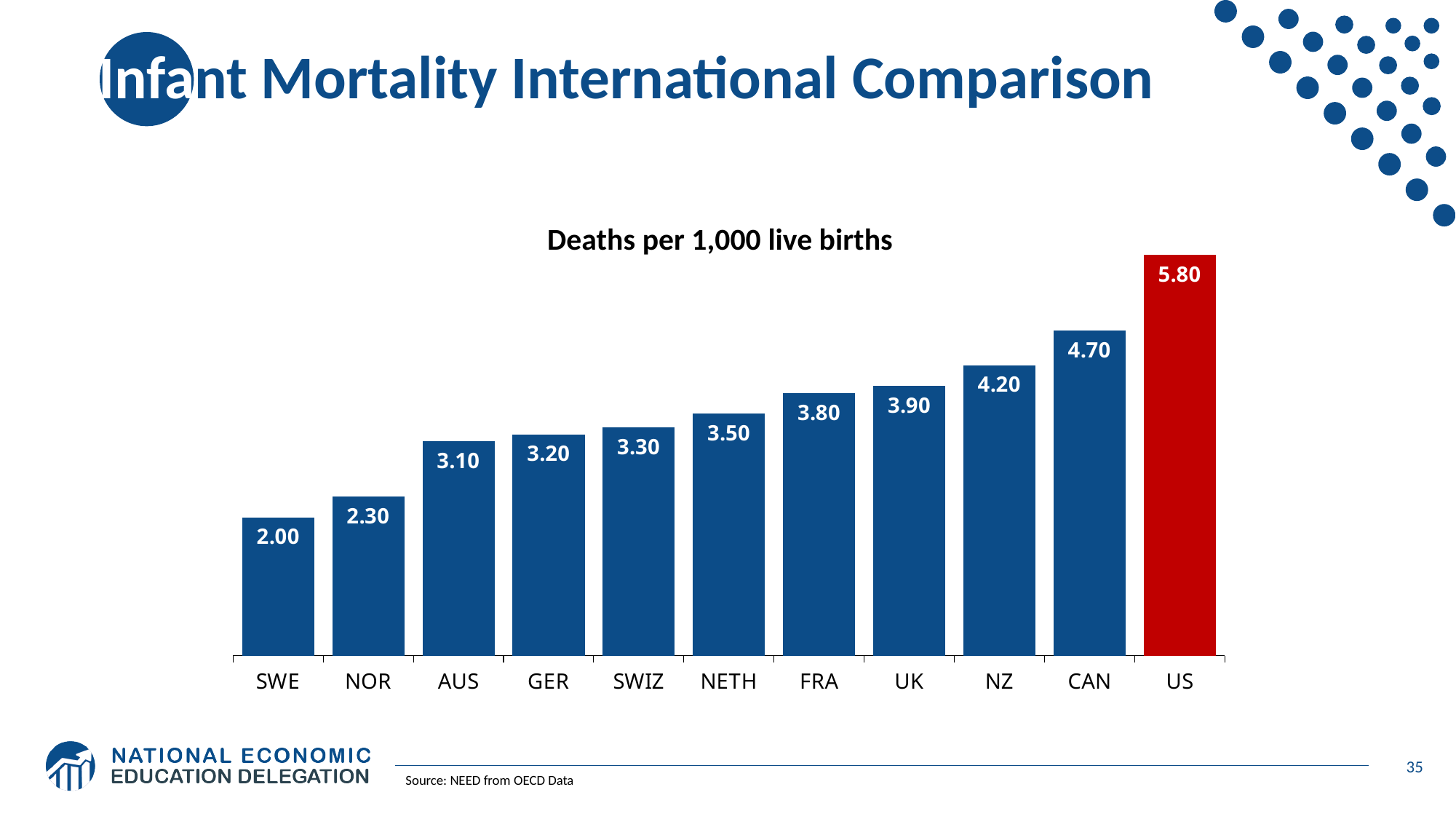
How many countries are shown on the chart? 11 Which country has the highest value? US What is the value for FRA? 3.80 What is the difference between the values for NOR and SWE? 0.30 What is the value for SWE? 2.00 What is the title of the chart? Deaths per 1,000 live births Which country has the lowest value? SWE Which is larger, the value for UK or the value for GER? UK Do the values rise or fall from left to right along the x axis? Rise What is the value for the US? 5.80 What kind of chart is this? Bar chart What is the difference between the values for the US and CAN? 1.10